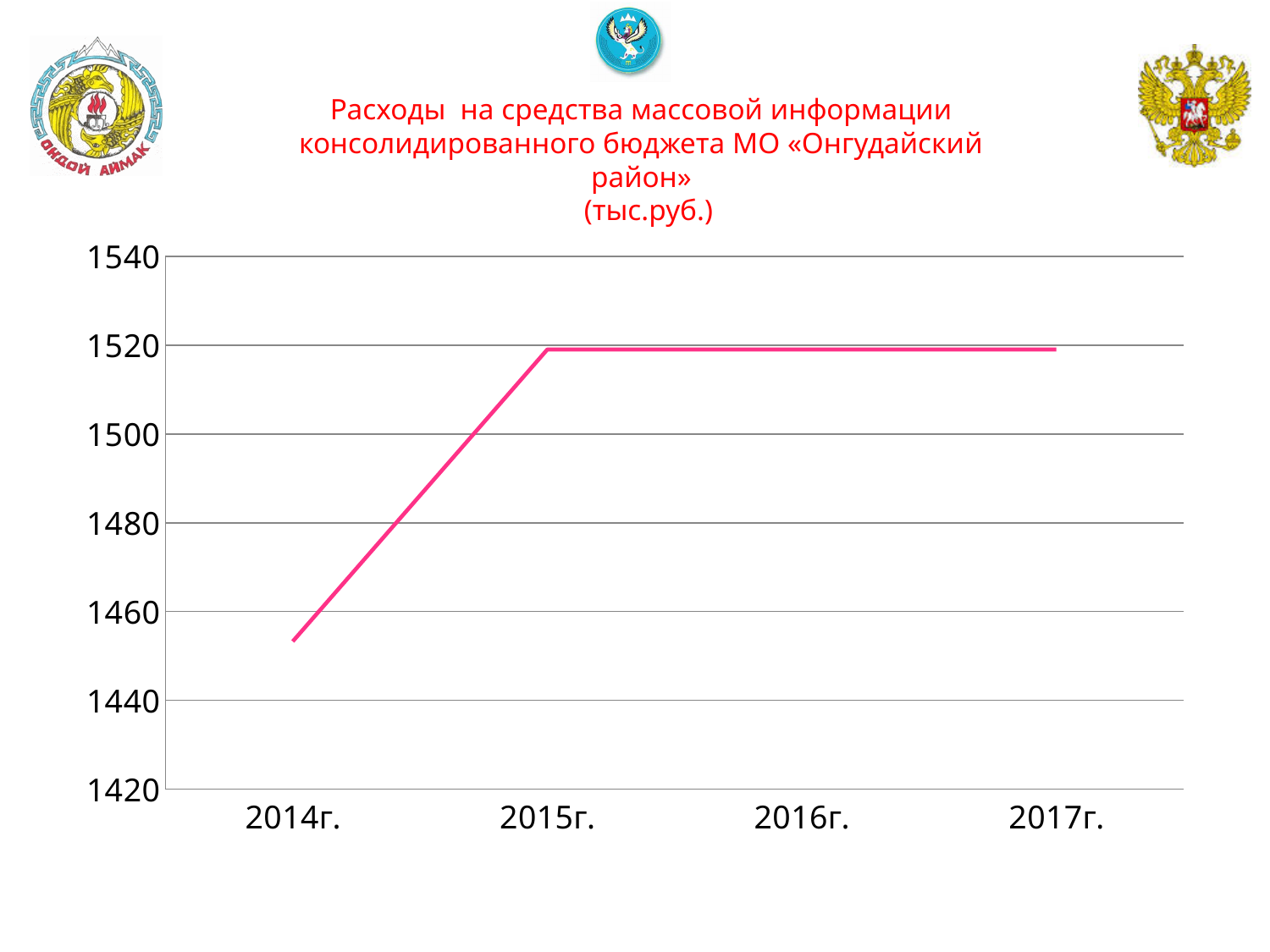
Is the value for 2014г. greater or less than 1460? less What kind of chart is shown on the slide? line chart How many years are plotted on the x axis of the chart? 4 Which year has the lowest value on the chart? 2014г. How does the value change from 2014г. to 2015г.? it rises How does the value change from 2015г. to 2017г.? it stays flat Which is larger, the value for 2014г. or the value for 2015г.? 2015г. Is the value for 2016г. greater or less than 1500? greater Is the value for 2015г. greater or less than 1500? greater What unit is given in the chart title? тыс.руб.